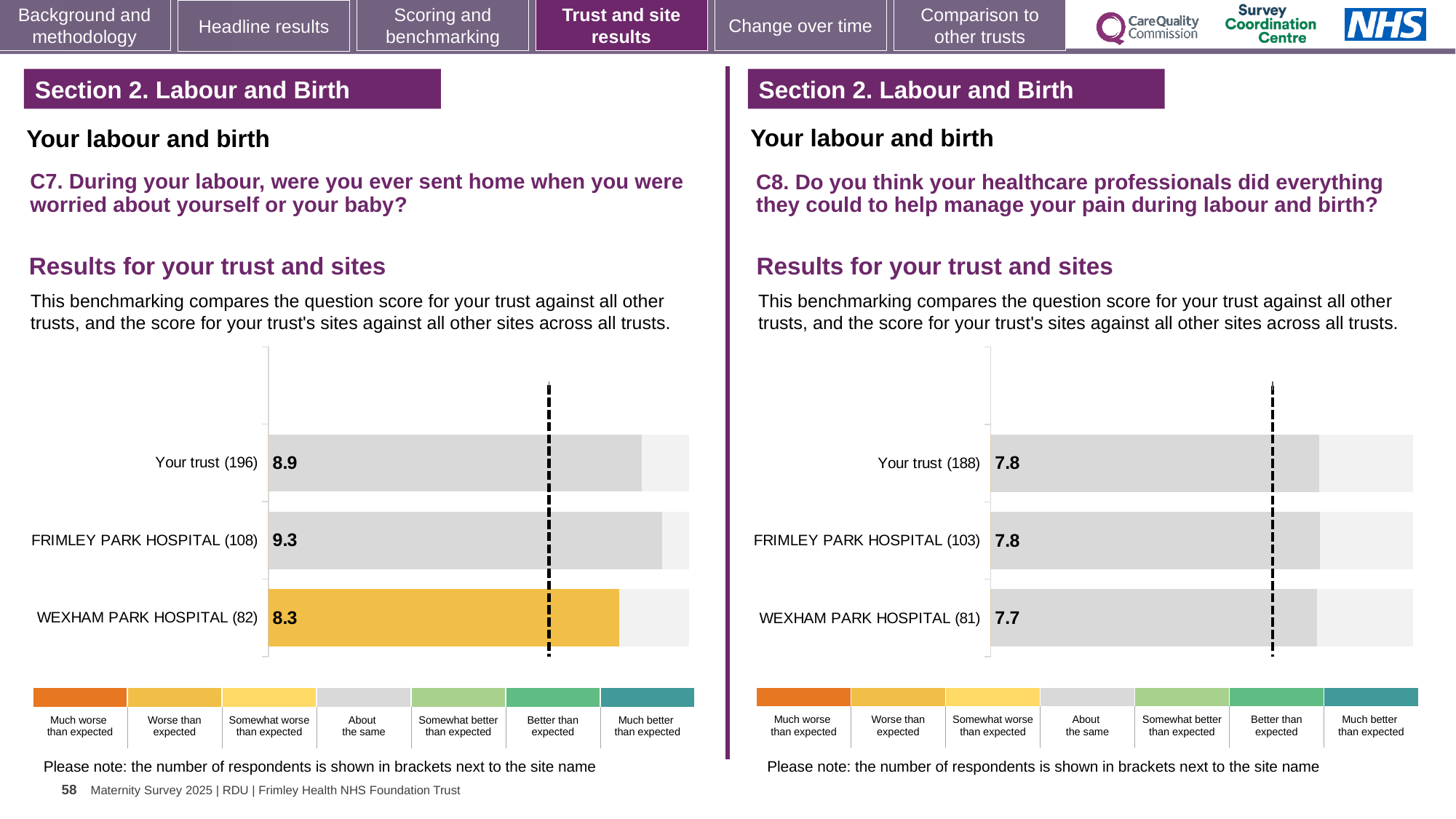
How many bars are plotted in the C8 chart on the right? 3 In the C7 chart on the left, what is the score for FRIMLEY PARK HOSPITAL? 9.3 In the C8 chart on the right, what is the score for FRIMLEY PARK HOSPITAL? 7.8 In the C7 chart on the left, what is the score for WEXHAM PARK HOSPITAL? 8.3 In the C7 chart on the left, which site or trust has the lowest score? WEXHAM PARK HOSPITAL In the C7 chart on the left, what is the difference between the scores for FRIMLEY PARK HOSPITAL and WEXHAM PARK HOSPITAL? 1.0 In the C8 chart on the right, what is the score for Your trust? 7.8 In the C7 chart on the left, which site or trust has the highest score? FRIMLEY PARK HOSPITAL In the C7 chart on the left, what is the score for Your trust? 8.9 In the C8 chart on the right, what is the score for WEXHAM PARK HOSPITAL? 7.7 In the C7 chart on the left, how many respondents are shown in brackets for WEXHAM PARK HOSPITAL? 82 What kind of chart is the C7 chart on the left? Bar chart